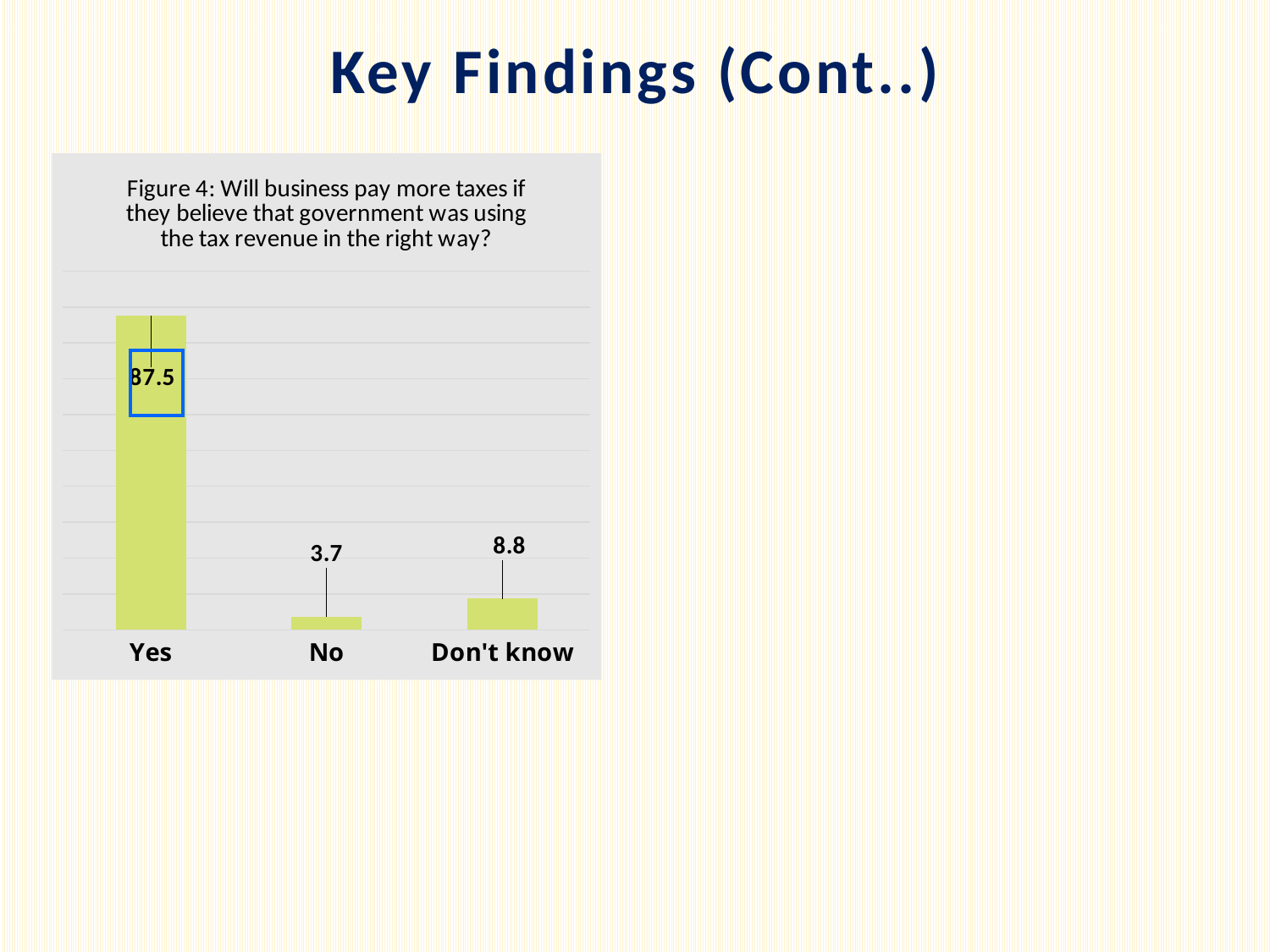
What is the value for No? 3.7 What colour are the bars in the chart? Light green What is the figure number given in the chart title? Figure 4 Which category has the lowest value? No How many categories are shown on the x axis? 3 What is the value for Don't know? 8.8 Which is larger, the value for No or the value for Don't know? Don't know What is the difference between the values for Don't know and No? 5.1 What is the difference between the values for Yes and Don't know? 78.7 What kind of chart is shown on the slide? Bar chart Which category has the highest value? Yes What is the value for Yes? 87.5